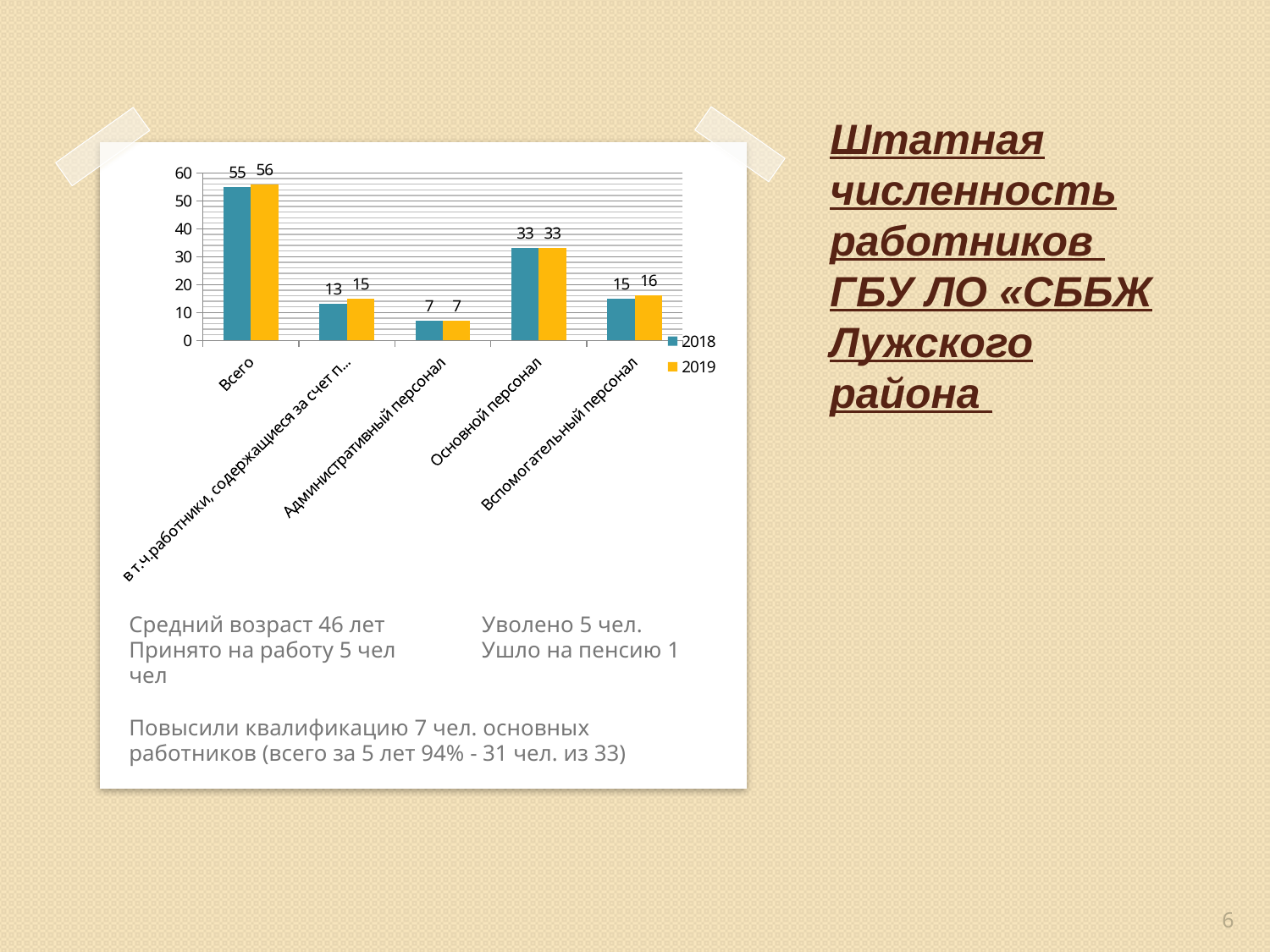
What is the difference between the 2019 and 2018 values for Вспомогательный персонал? 1 How many series does the chart legend list? 2 How many categories are shown on the x axis of the chart? 5 What is the value for Основной персонал in 2018? 33 What type of chart is shown on the slide? Bar chart Which is larger: the 2018 value for Основной персонал or the 2018 value for Вспомогательный персонал? Основной персонал What is the value for Всего in 2019? 56 What is the value for Административный персонал in 2019? 7 What is the value for Всего in 2018? 55 Which category has the lowest value in 2018? Административный персонал What is the value for Вспомогательный персонал in 2019? 16 Which category has the highest value in 2019? Всего